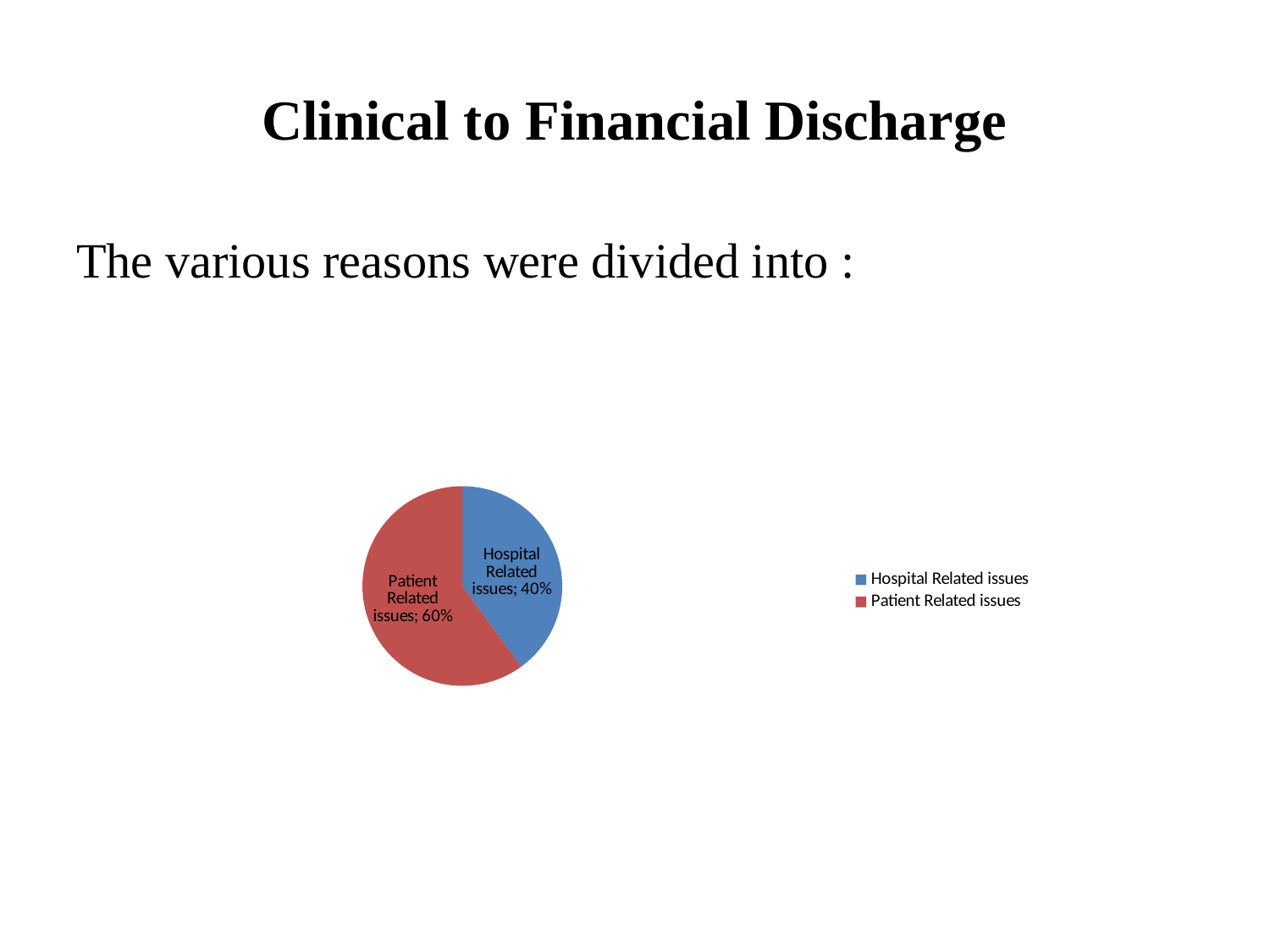
Which category has the largest share of the pie? Patient Related issues What colour is the slice for Patient Related issues? red Which category has the smallest share of the pie? Hospital Related issues What share of the pie is Hospital Related issues? 40% Which is larger, the share for Hospital Related issues or the share for Patient Related issues? Patient Related issues What kind of chart is shown on the slide? pie chart What colour is the slice for Hospital Related issues? blue What share of the pie is Patient Related issues? 60% How many entries does the legend list? 2 How many slices does the pie chart have? 2 What is the difference in percentage points between Patient Related issues and Hospital Related issues? 20%